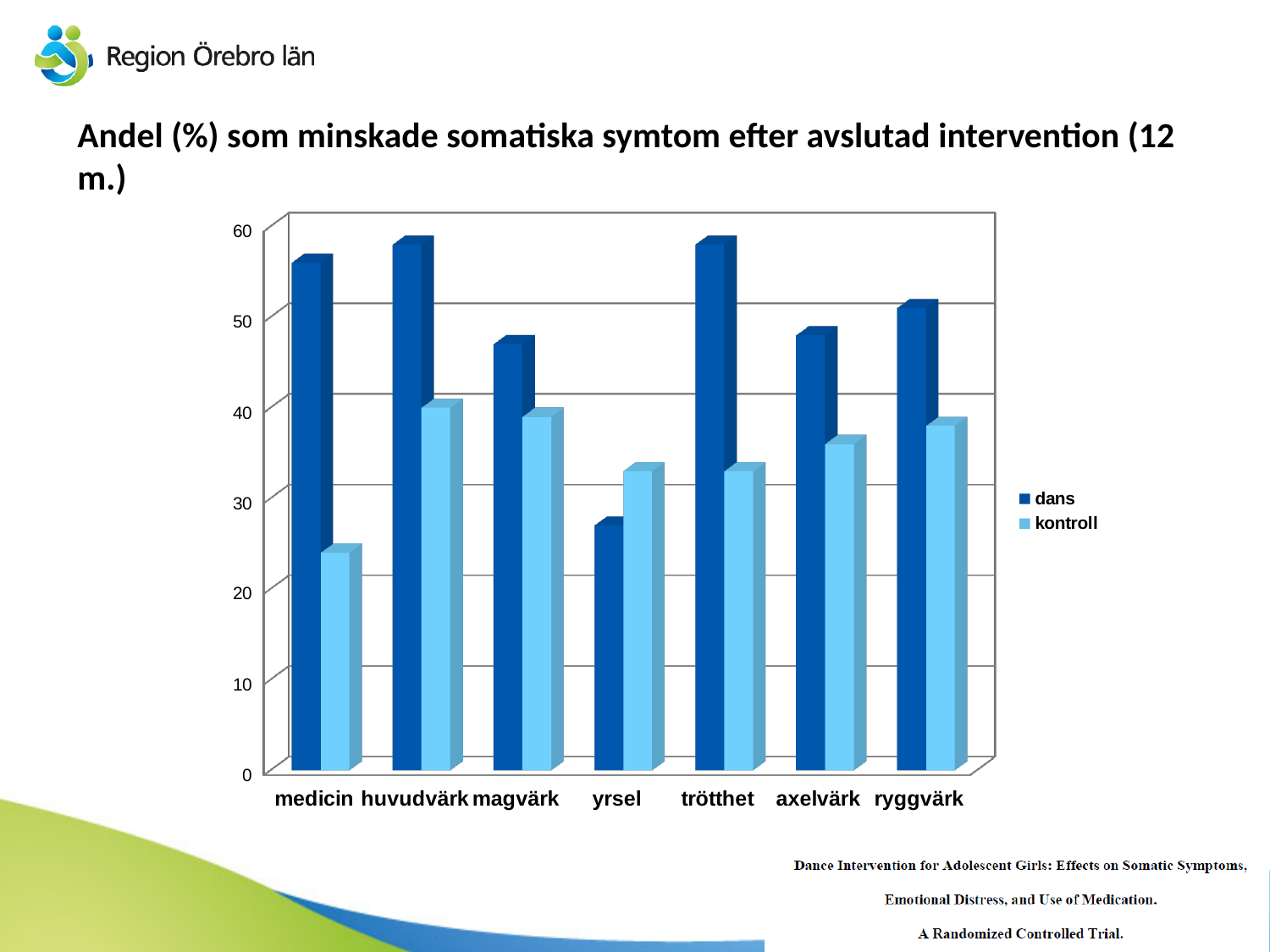
For yrsel, which series has the larger value, dans or kontroll? kontroll Is the kontroll value for medicin greater or less than 30? less How many series does the legend list? 2 Is the kontroll value for axelvärk greater or less than 30? greater What are the two series named in the legend? dans and kontroll Is the dans value for medicin greater or less than 50? greater What kind of chart is shown on the slide? bar chart Which category has the lowest value for the dans series? yrsel How many categories are shown on the x axis? 7 Which category has the lowest value for the kontroll series? medicin For trötthet, which series has the larger value, dans or kontroll? dans